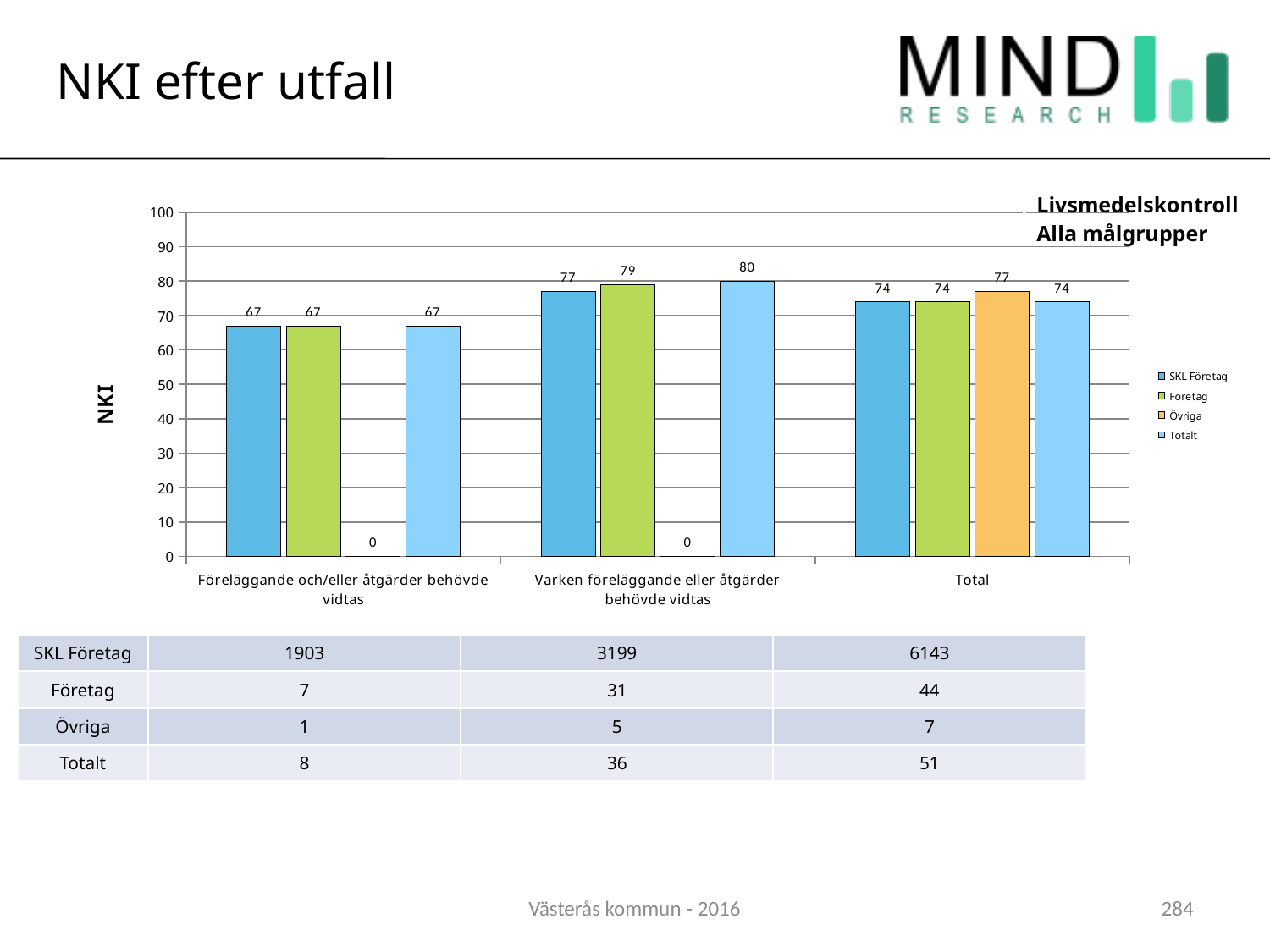
Which is larger: the Företag value for "Varken föreläggande eller åtgärder behövde vidtas" or the Företag value for "Total"? Varken föreläggande eller åtgärder behövde vidtas What is the NKI value for Totalt in the category "Föreläggande och/eller åtgärder behövde vidtas"? 67 How many series does the chart legend list? 4 What is the difference between the Totalt NKI value for "Varken föreläggande eller åtgärder behövde vidtas" and for "Föreläggande och/eller åtgärder behövde vidtas"? 13 What kind of chart is shown on the slide? Bar chart Which series has the highest NKI value in the category "Varken föreläggande eller åtgärder behövde vidtas"? Totalt What is the label on the vertical axis of the chart? NKI Which series has the lowest NKI value in the "Total" category? SKL Företag, Företag and Totalt (all 74) What is the NKI value for Övriga in the "Total" category? 77 What is the NKI value for Företag in the category "Varken föreläggande eller åtgärder behövde vidtas"? 79 What is the NKI value for SKL Företag in the category "Varken föreläggande eller åtgärder behövde vidtas"? 77 How many categories are shown on the x axis of the chart? 3